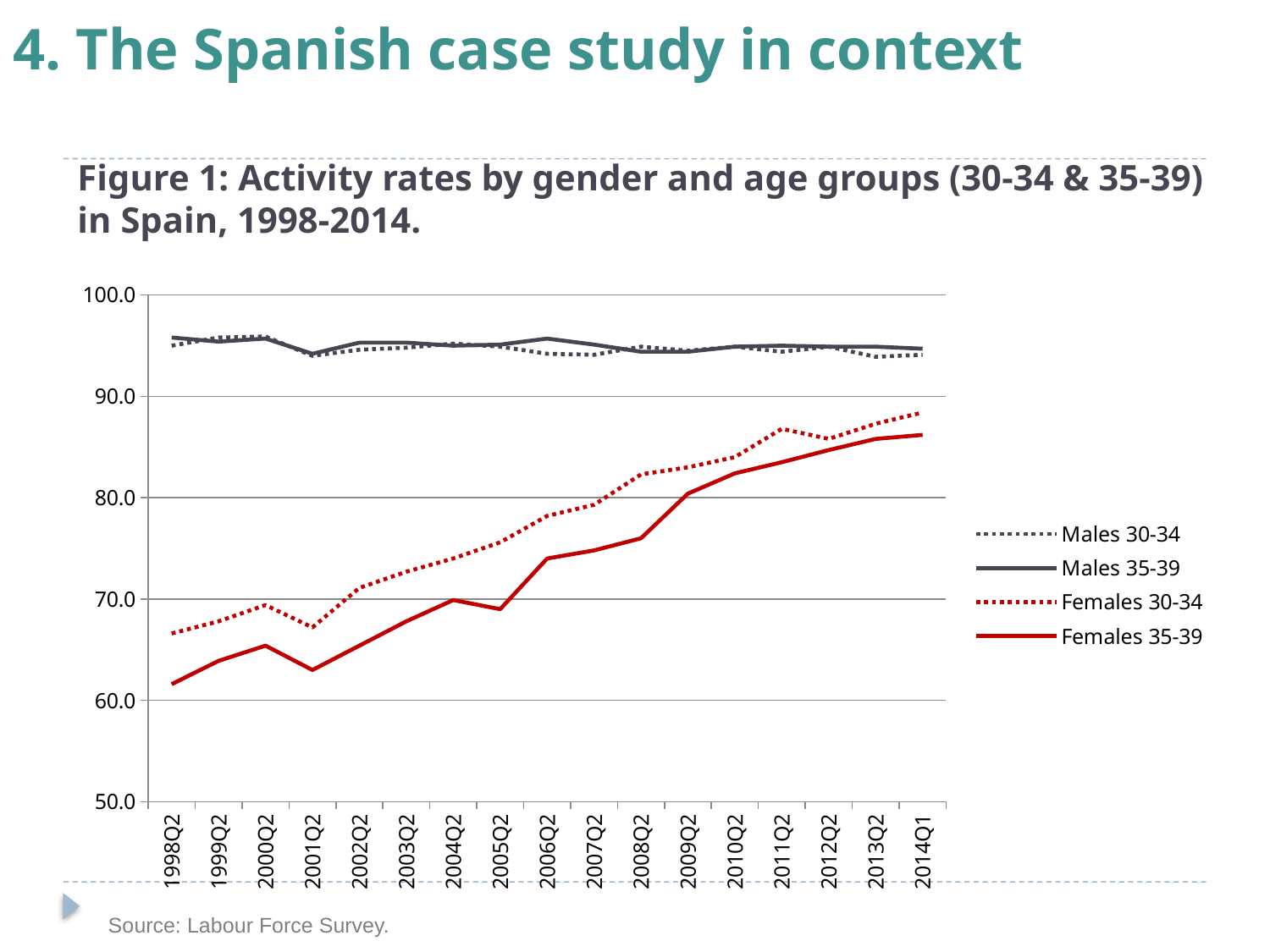
Is the value for Females 35-39 at 2008Q2 greater or less than 80.0? less What colour are the lines for the two Females series in the chart? red What kind of chart is shown in Figure 1? line chart How many series does the legend of Figure 1 list? 4 How many time points are labelled on the x axis of Figure 1? 17 At 1998Q2, which is higher: Males 35-39 or Females 35-39? Males 35-39 Is the value for Males 35-39 at 2006Q2 greater or less than 90.0? greater Does the Females 35-39 line rise or fall from 1998Q2 to 2014Q1? rise Is the value for Females 30-34 at 2014Q1 greater or less than 80.0? greater At 2005Q2, which is higher: Females 30-34 or Females 35-39? Females 30-34 Which series has the lowest value at 1998Q2? Females 35-39